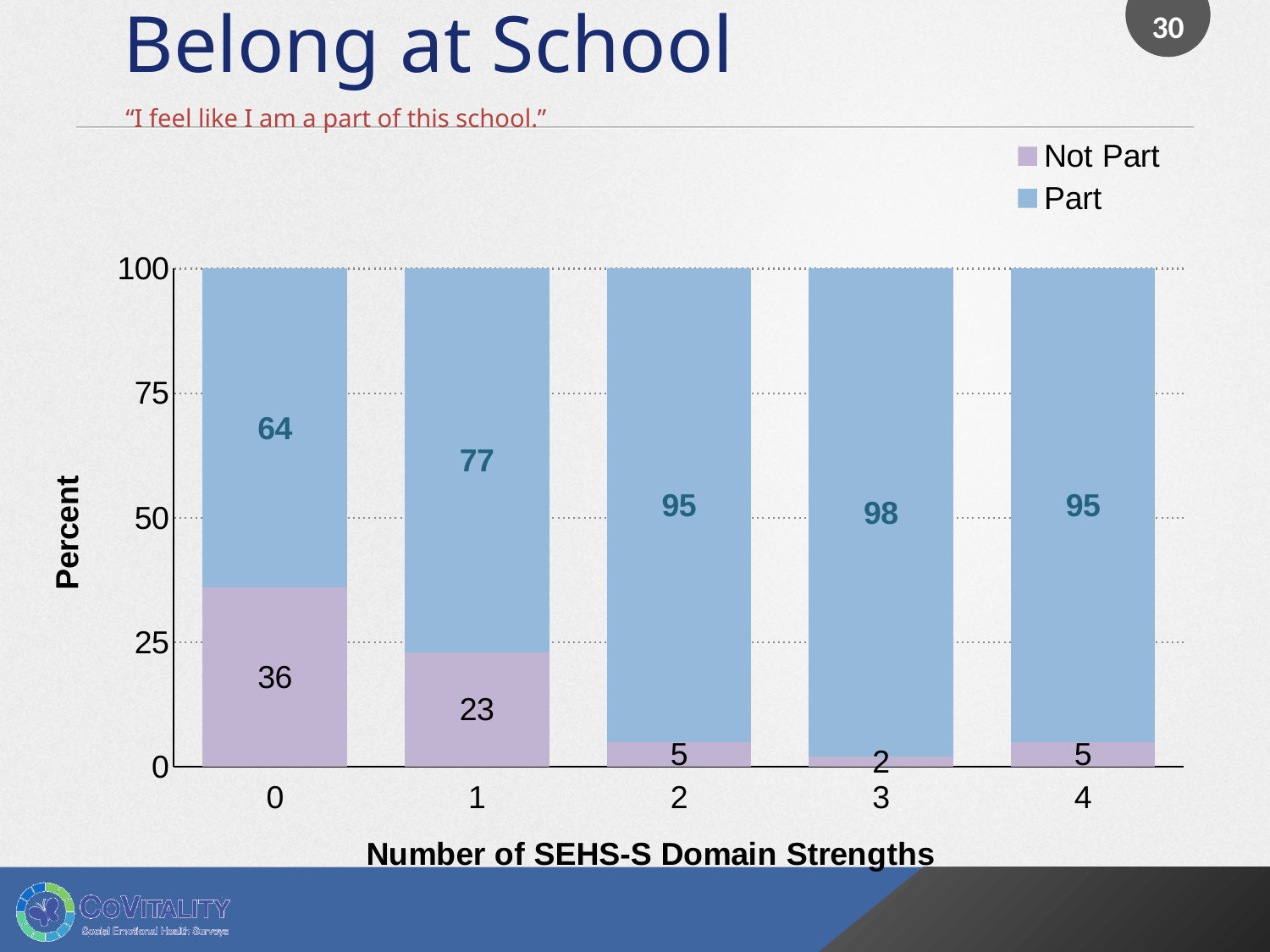
Does the "Not Part" value generally rise or fall as the number of SEHS-S domain strengths increases from 0 to 3? Fall What kind of chart is shown on the slide? Stacked bar chart How many series does the legend list? 2 What is the value for "Part" at 0 SEHS-S domain strengths? 64 Is the "Part" value larger at 1 or at 2 SEHS-S domain strengths? 2 What is the difference between the "Not Part" values at 0 and 1 SEHS-S domain strengths? 13 Which number of SEHS-S domain strengths has the highest "Part" value? 3 What is the value for "Not Part" at 3 SEHS-S domain strengths? 2 How many categories are shown on the x axis? 5 What is the value for "Not Part" at 1 SEHS-S domain strength? 23 What is the label of the y axis? Percent Which number of SEHS-S domain strengths has the lowest "Not Part" value? 3